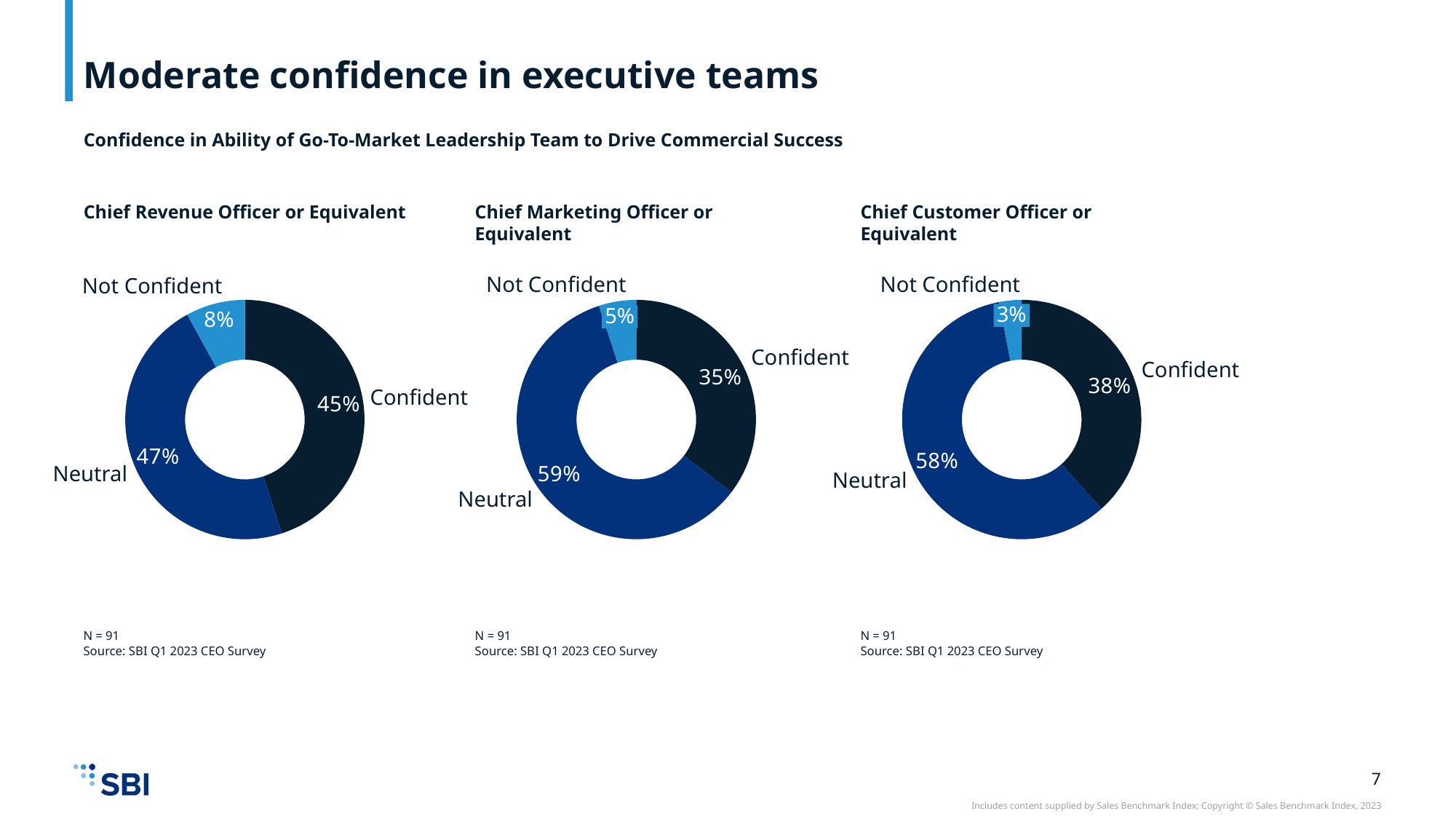
In the Chief Revenue Officer or Equivalent chart, which category has the largest share? Neutral In the Chief Marketing Officer or Equivalent chart, which is larger, Confident or Neutral? Neutral In the Chief Customer Officer or Equivalent chart, what is the difference between the Neutral and Confident shares? 20 percentage points Which chart has the higher Confident share, Chief Revenue Officer or Equivalent or Chief Customer Officer or Equivalent? Chief Revenue Officer or Equivalent In the Chief Marketing Officer or Equivalent chart, which category has the smallest share? Not Confident What kind of chart is used for Chief Revenue Officer or Equivalent? Doughnut chart In the Chief Revenue Officer or Equivalent chart, what percentage is Confident? 45% In the Chief Revenue Officer or Equivalent chart, what is the difference between the Confident and Not Confident shares? 37 percentage points In the Chief Customer Officer or Equivalent chart, what percentage is Not Confident? 3% How many categories does the Chief Customer Officer or Equivalent chart show? 3 How many charts are shown on the slide? 3 In the Chief Marketing Officer or Equivalent chart, what percentage is Neutral? 59%